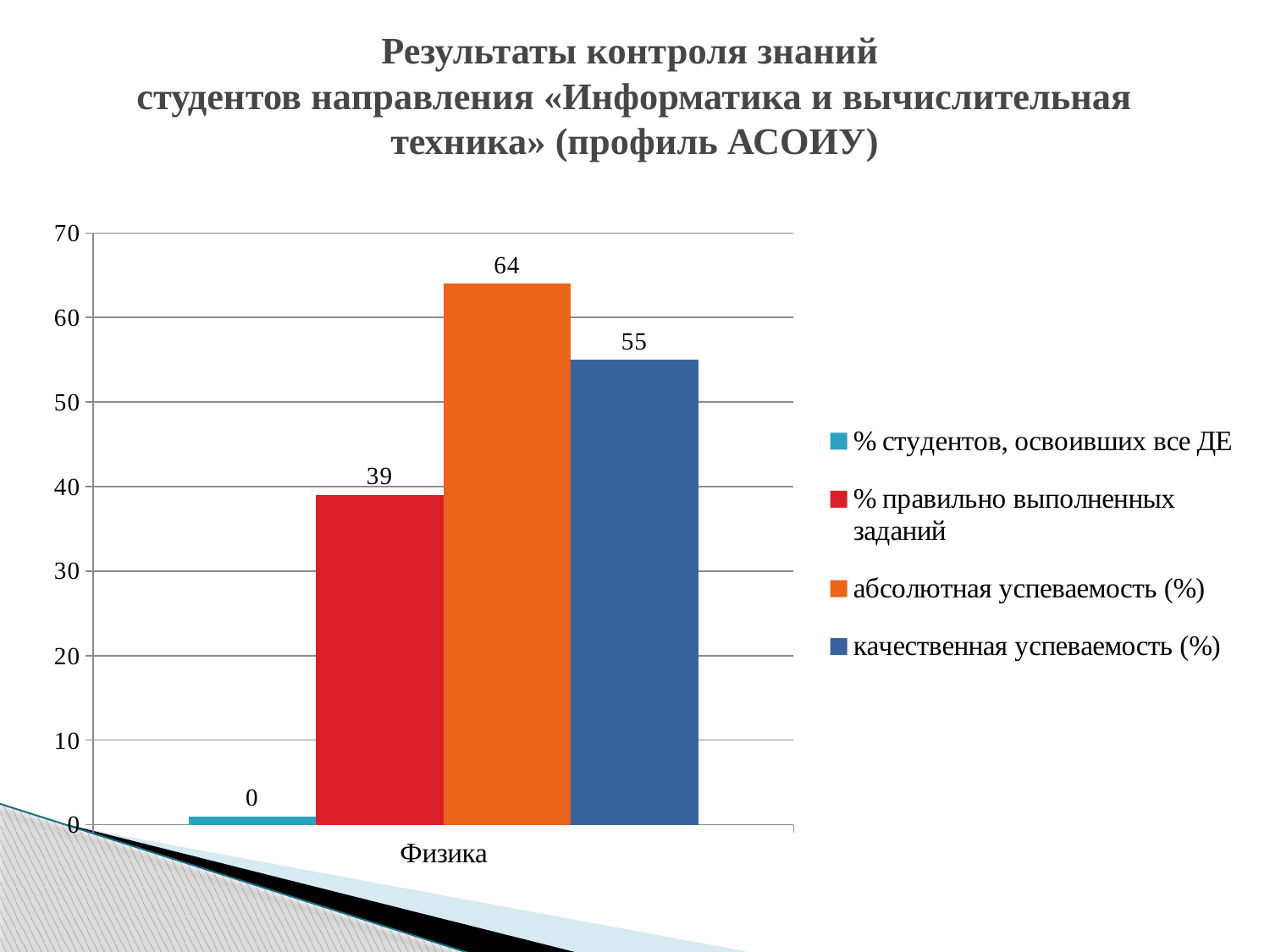
What is the value of «% студентов, освоивших все ДЕ» for Физика? 0 Which series has the highest value for Физика? абсолютная успеваемость (%) How many categories are shown on the x axis? 1 How many series does the legend list? 4 Which is larger for Физика: «качественная успеваемость (%)» or «% правильно выполненных заданий»? качественная успеваемость (%) What is the value of «% правильно выполненных заданий» for Физика? 39 What is the difference between «абсолютная успеваемость (%)» and «% правильно выполненных заданий» for Физика? 25 What is the value of «качественная успеваемость (%)» for Физика? 55 What is the difference between «абсолютная успеваемость (%)» and «качественная успеваемость (%)» for Физика? 9 What is the value of «абсолютная успеваемость (%)» for Физика? 64 Which series has the lowest value for Физика? % студентов, освоивших все ДЕ What kind of chart is shown on the slide? Bar chart